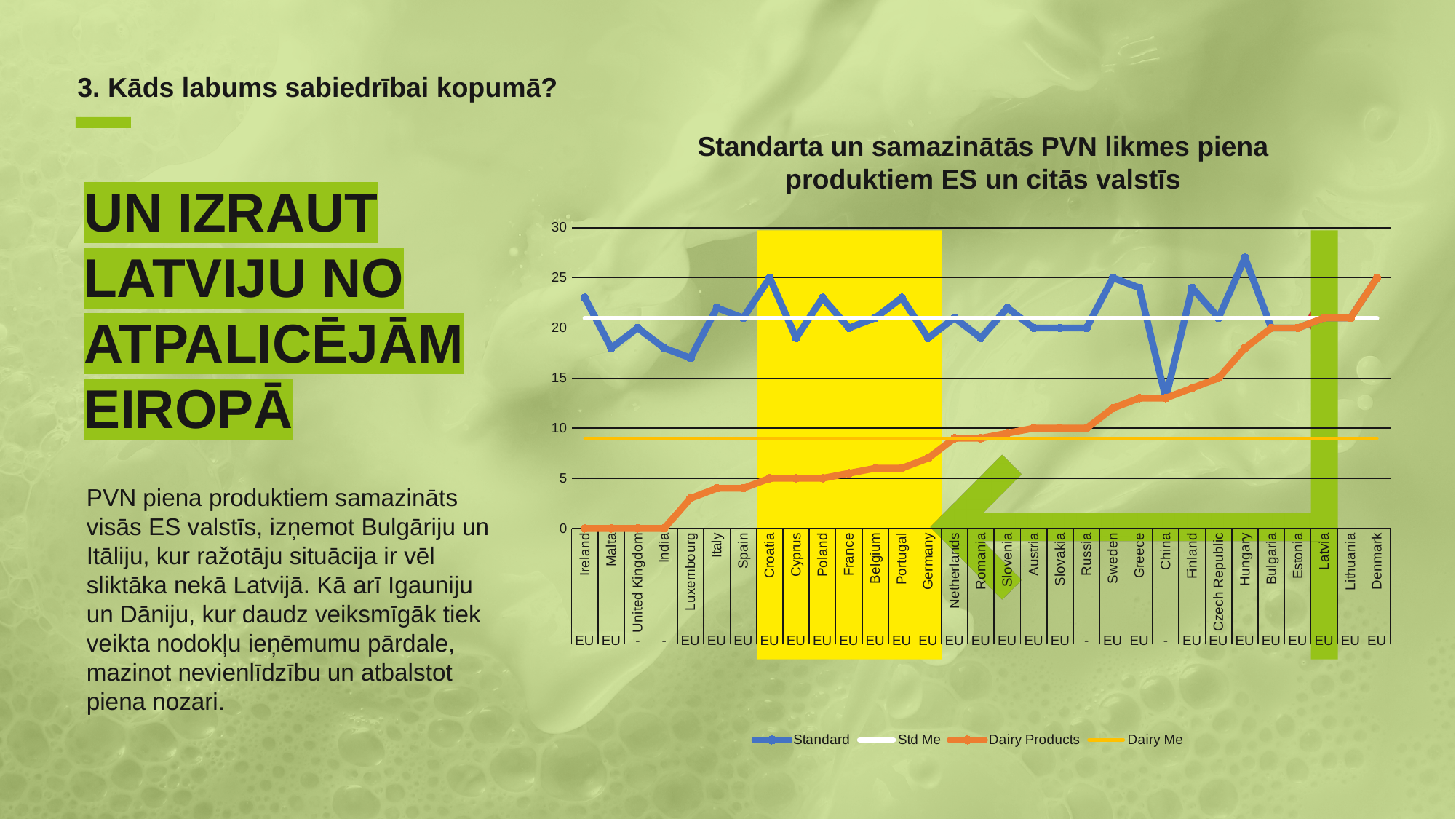
Does the Dairy Products line generally rise or fall from left to right along the x axis? rise Which country has the highest Standard value in the chart? Hungary Which is larger, the Standard value for Hungary or the Standard value for China? Hungary Which country has the lowest Standard value in the chart? China Which country has the highest Dairy Products value in the chart? Denmark Is the Dairy Products value for Germany greater or less than 10? less How many series does the chart legend list? 4 What kind of chart is shown on the slide? line chart How many countries are plotted along the x axis of the chart? 31 What is the title of the chart? Standarta un samazinātās PVN likmes piena produktiem ES un citās valstīs Is the Standard value for Luxembourg greater or less than 20? less Is the Dairy Products value for Latvia greater or less than 15? greater